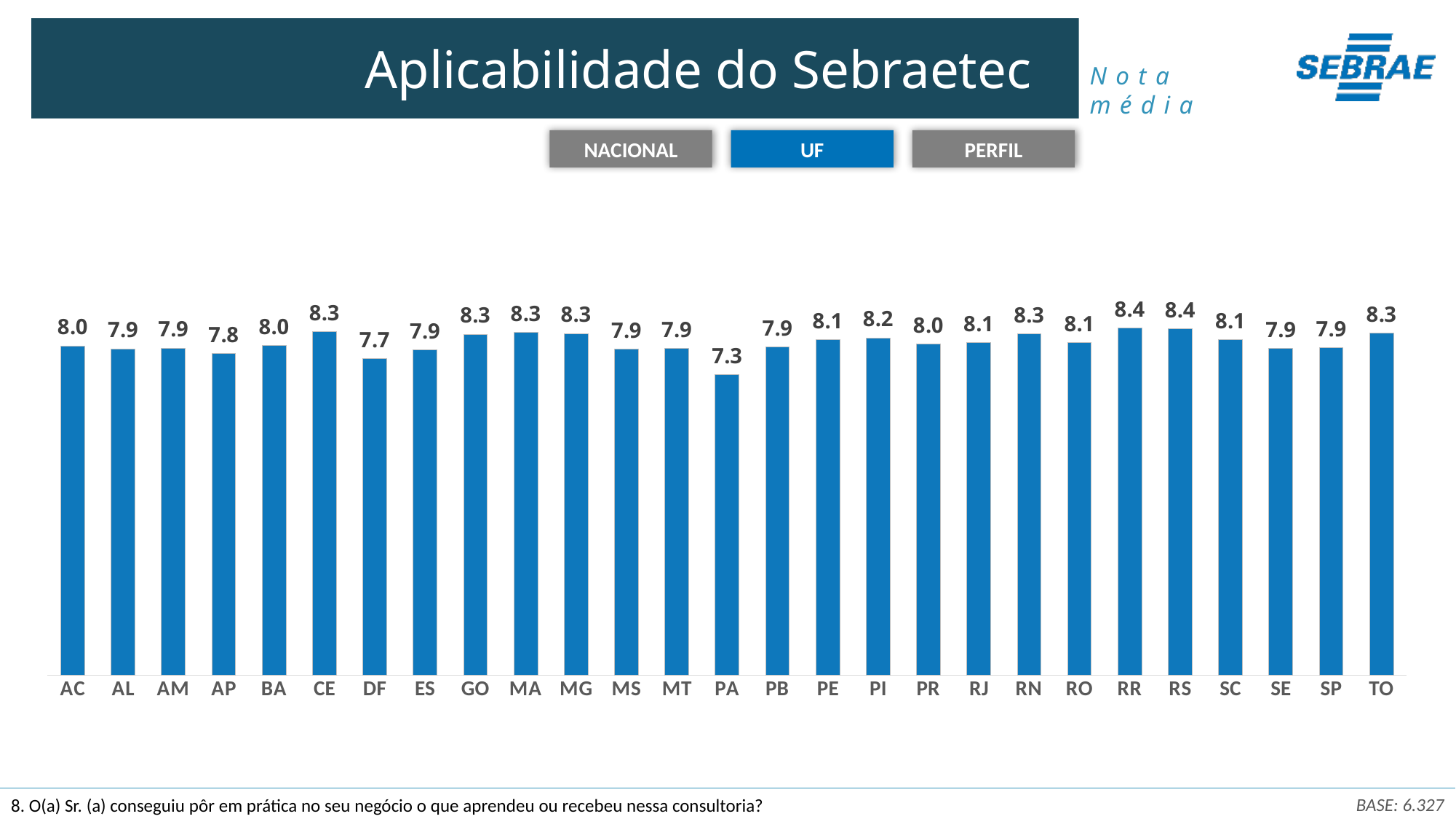
What is the difference between the values for RR and PA? 1.1 What type of chart is shown on the slide? Bar chart What is the value shown for DF? 7.7 What is the average score (nota média) for CE? 8.3 What is the highest value shown on the chart? 8.4 How many states (UFs) are shown on the chart? 27 What is the title of the slide containing the chart? Aplicabilidade do Sebraetec Which state (UF) has the lowest average score? PA Which has a higher value, PI or AP? PI What is the value shown for PA? 7.3 What is the value shown for PI? 8.2 What is the difference between the values for CE and DF? 0.6